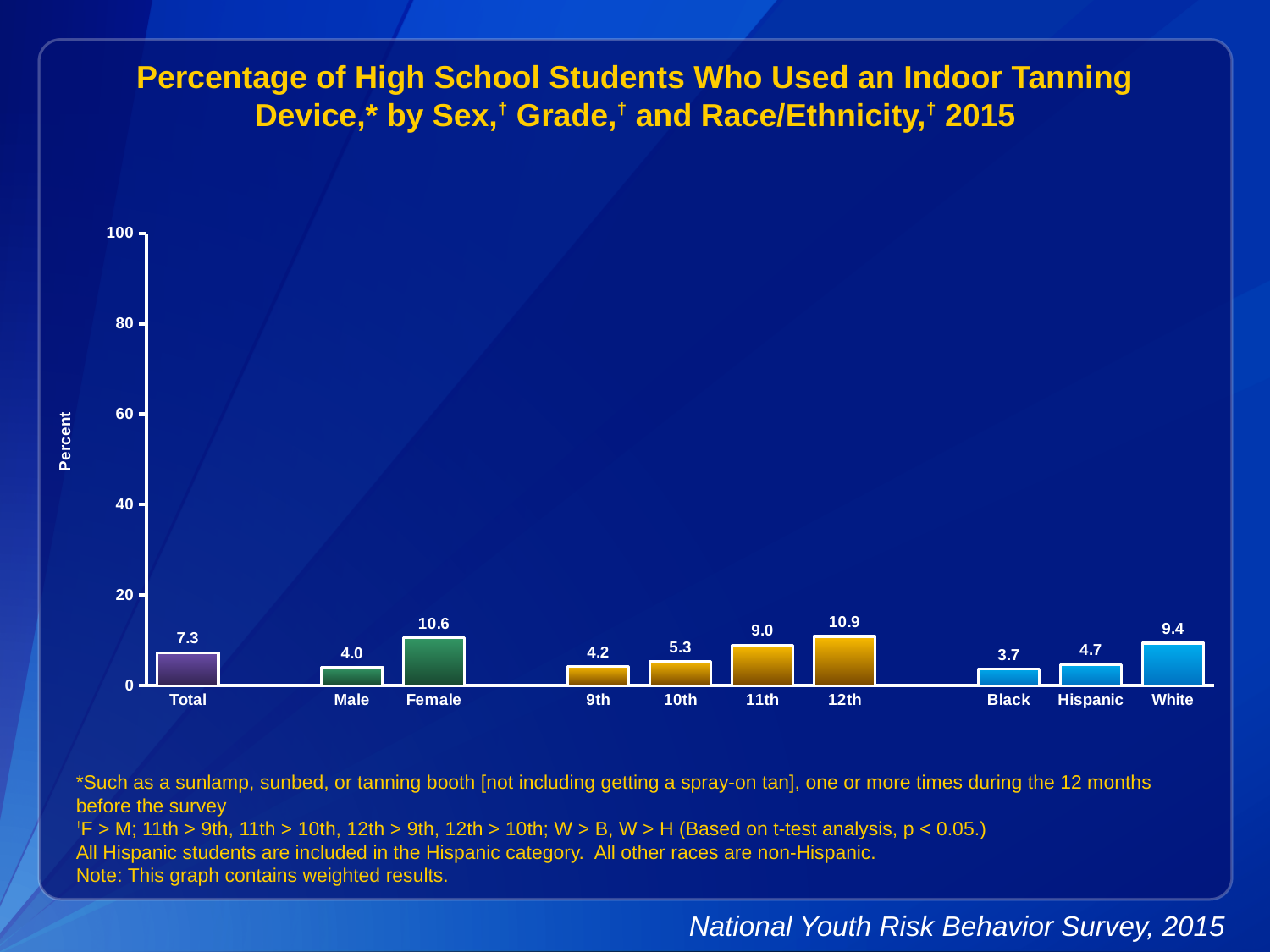
How many categories are shown on the x axis? 10 Which category has the lowest value? Black What is the value for Female? 10.6 Which category has the highest value? 12th Is the value for 11th grade greater or less than 20? less Which is larger, the value for White or the value for Black? White Do the values rise or fall from 9th grade to 12th grade? rise What is the value for 12th grade? 10.9 What is the difference between the Female and Male values? 6.6 What is the value for Total? 7.3 What kind of chart is this? bar chart What is the value for Hispanic? 4.7